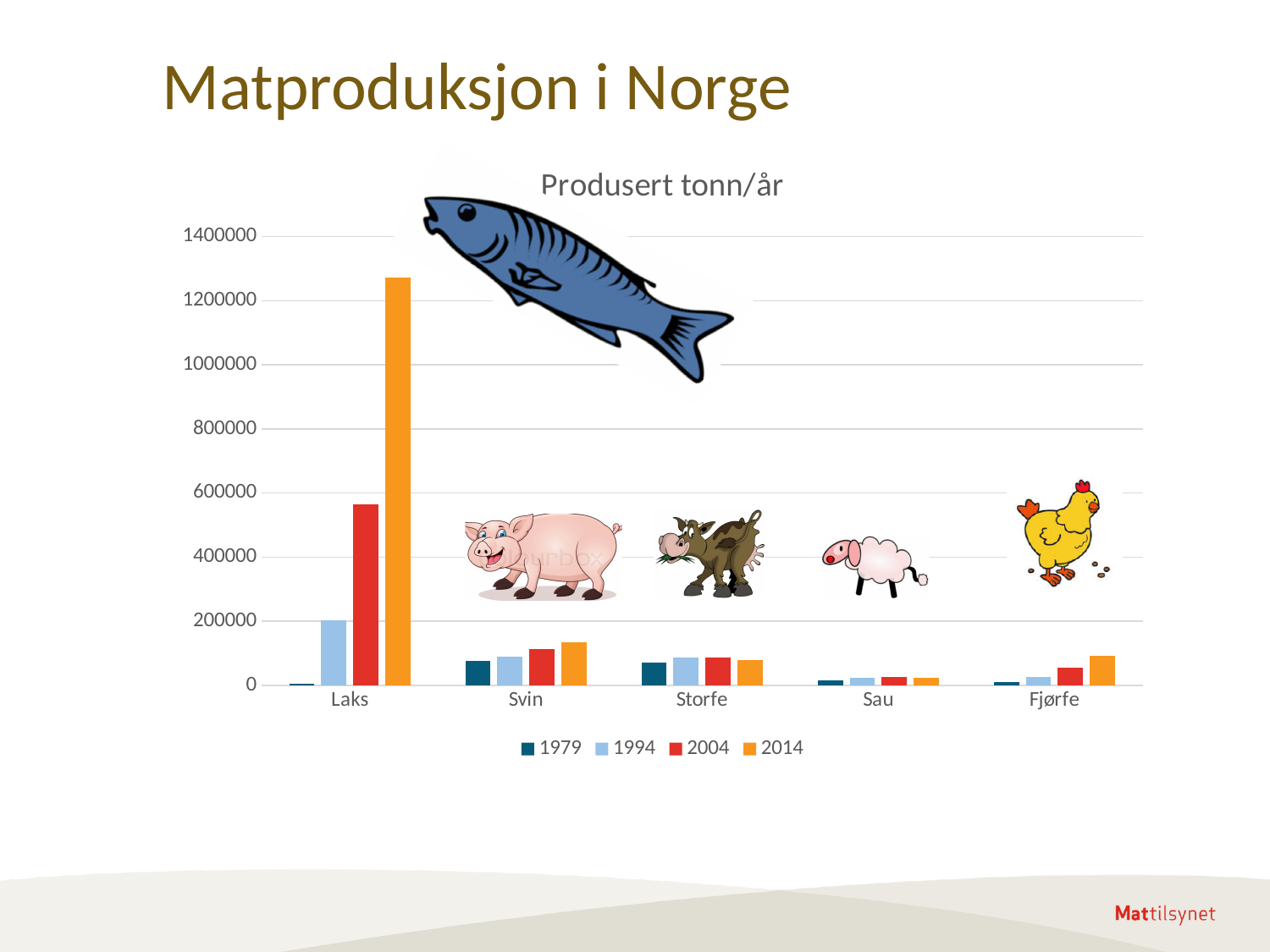
What kind of chart is shown on the slide? Bar chart Do the values for Fjørfe rise or fall from 1979 to 2014? rise Which year has the highest value for Laks? 2014 Which category has the highest bar in the chart? Laks Which is larger, the 2014 value for Laks or the 2014 value for Svin? Laks Is the value for Laks in 2004 greater or less than 400000? greater Which colour represents the 2014 series in the legend? Orange Is the value for Laks in 2014 greater or less than 1200000? greater Is the value for Svin in 2014 greater or less than 200000? less What is the title of the chart? Produsert tonn/år How many series does the legend list? 4 How many categories are shown on the x axis? 5